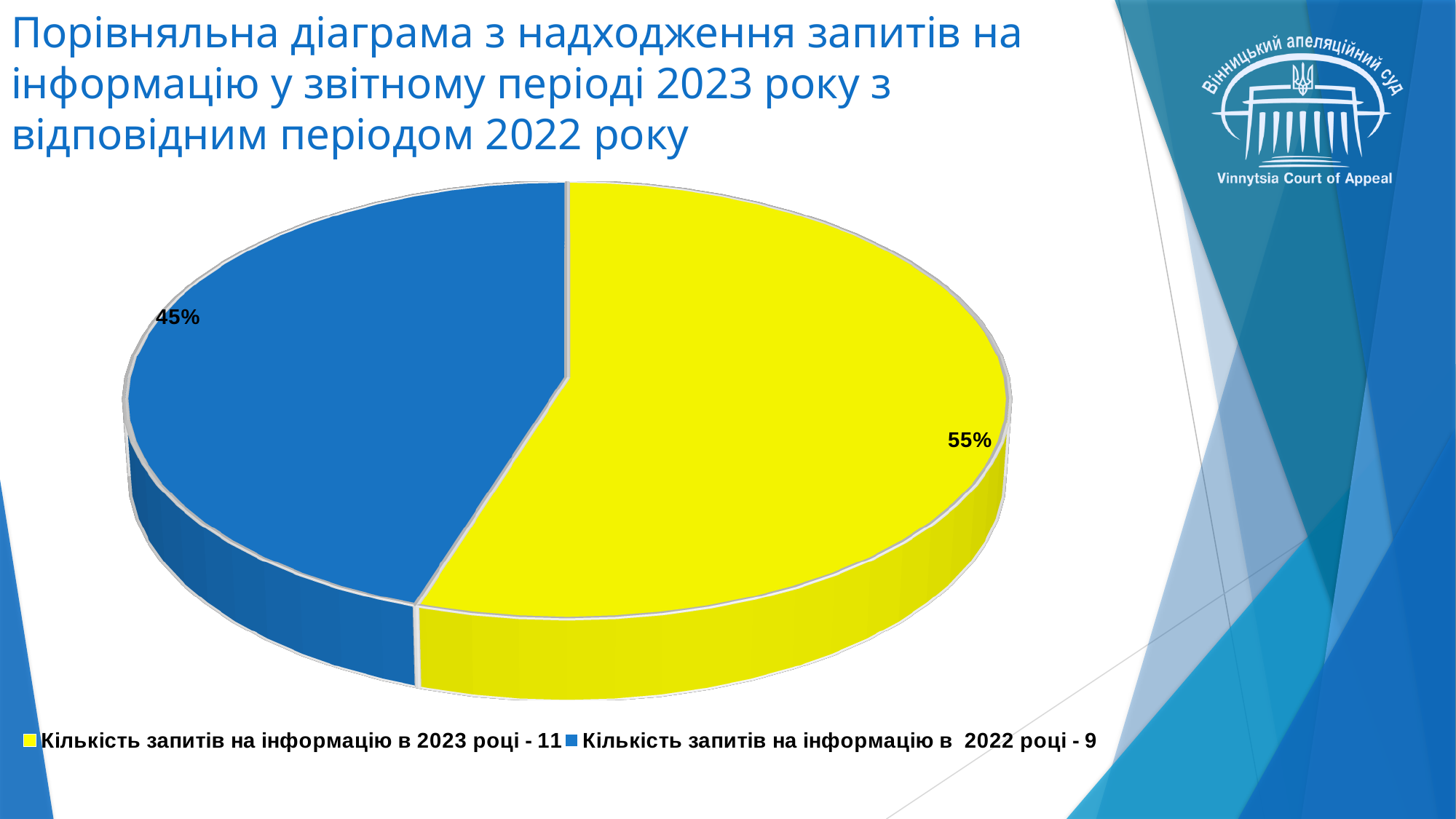
What percentage share is shown for the blue slice (requests for information in 2022)? 45% What kind of chart is shown on the slide? Pie chart Which colour represents the requests for information in 2022? Blue Which slice of the pie chart is the smallest? Кількість запитів на інформацію в 2022 році - 9 How many entries does the legend of the pie chart list? 2 According to the legend, how many requests for information were received in 2022? 9 What percentage share is shown for the yellow slice (requests for information in 2023)? 55% What is the difference in percentage points between the 2023 slice and the 2022 slice? 10 percentage points Which year has the larger share of the pie, 2023 or 2022? 2023 According to the legend, how many requests for information were received in 2023? 11 What is the difference between the number of requests in 2023 and in 2022 as given in the legend? 2 How many slices does the pie chart have? 2